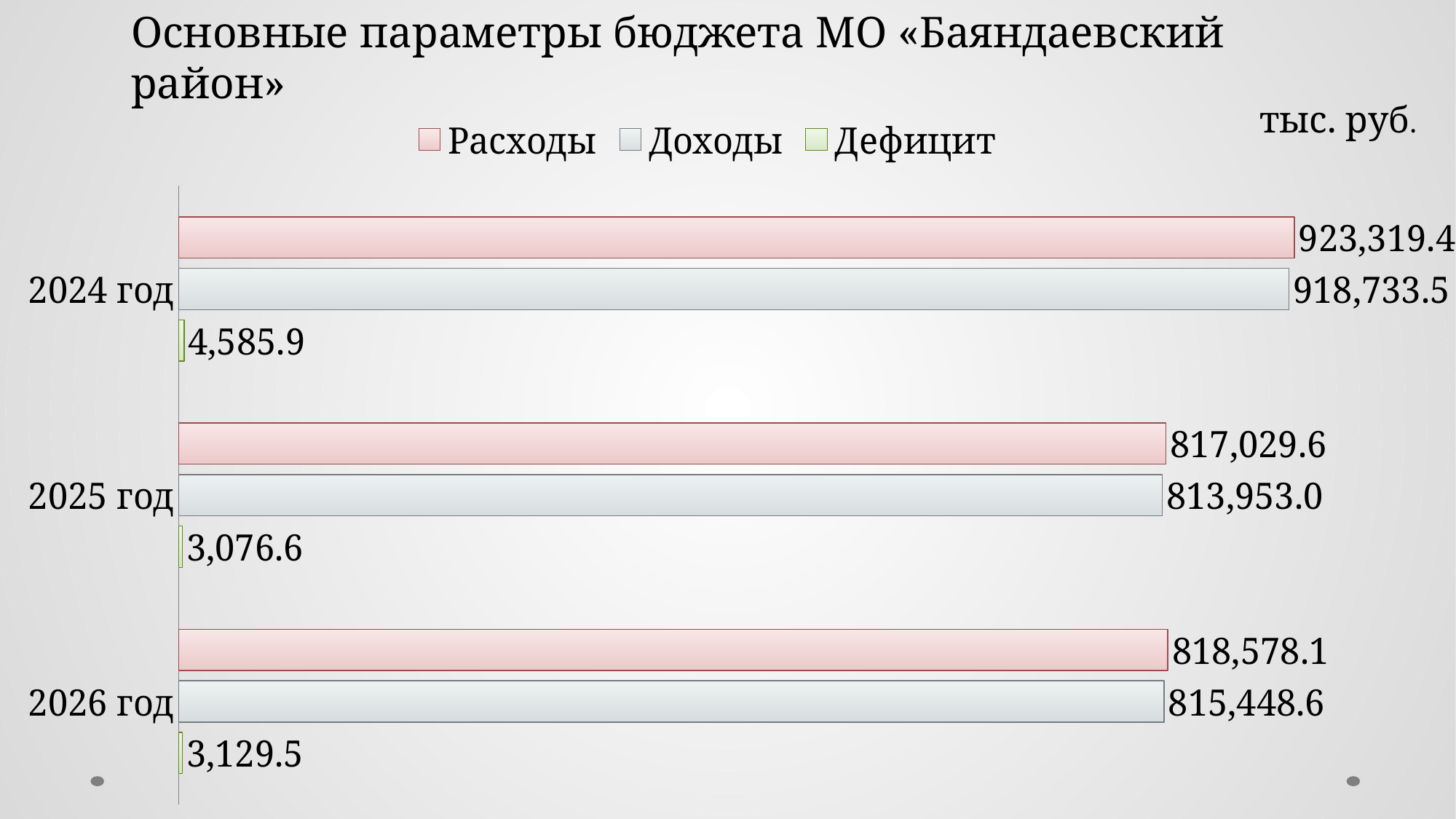
Which is larger: Доходы for 2024 год or Доходы for 2026 год? 2024 год How many series does the legend list? 3 In which year is Дефицит the lowest? 2025 год What is the value of Расходы for 2024 год? 923,319.4 What is the difference between Расходы and Доходы for 2024 год? 4,585.9 How many years (categories) are shown on the chart? 3 What kind of chart is shown on the slide? bar chart In which year are Расходы the highest? 2024 год What is the value of Доходы for 2025 год? 813,953.0 What is the difference between Расходы for 2026 год and Расходы for 2025 год? 1,548.5 What is the value of Дефицит for 2026 год? 3,129.5 In what units are the values on the chart expressed? тыс. руб.